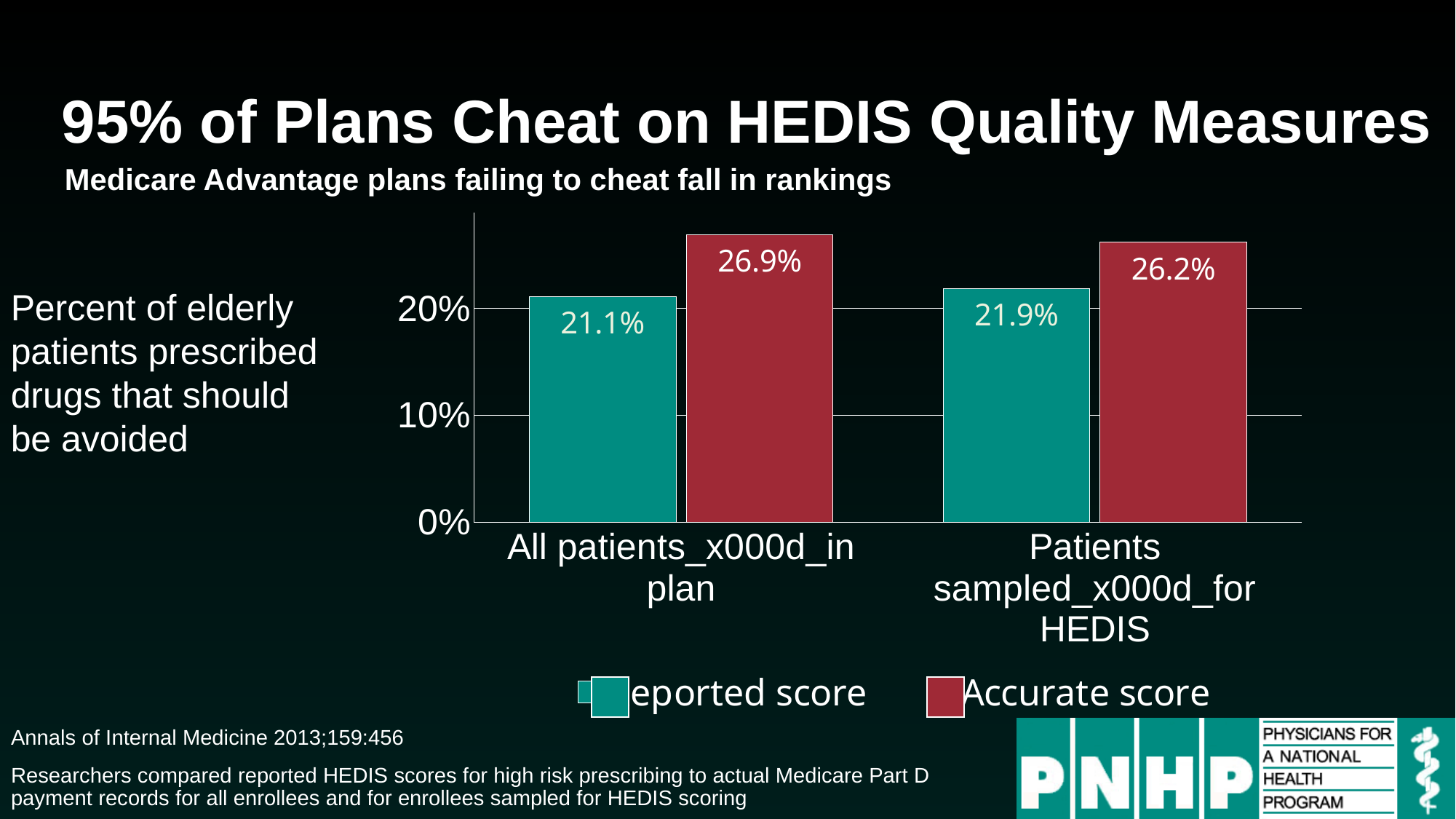
What is the Accurate score for All patients in plan? 26.9% What kind of chart is shown on the slide? Bar chart Which bar has the lowest value on the chart? Reported score for All patients in plan (21.1%) What is the difference between the Accurate score and the Reported score for All patients in plan? 5.8 percentage points What is the Reported score for Patients sampled for HEDIS? 21.9% How many series does the chart's legend list? 2 What is the Reported score for All patients in plan? 21.1% What is the difference between the Accurate score and the Reported score for Patients sampled for HEDIS? 4.3 percentage points Which bar has the highest value on the chart? Accurate score for All patients in plan (26.9%) What is the Accurate score for Patients sampled for HEDIS? 26.2% How many categories are shown on the x axis of the chart? 2 For Patients sampled for HEDIS, which is larger: the Reported score or the Accurate score? Accurate score